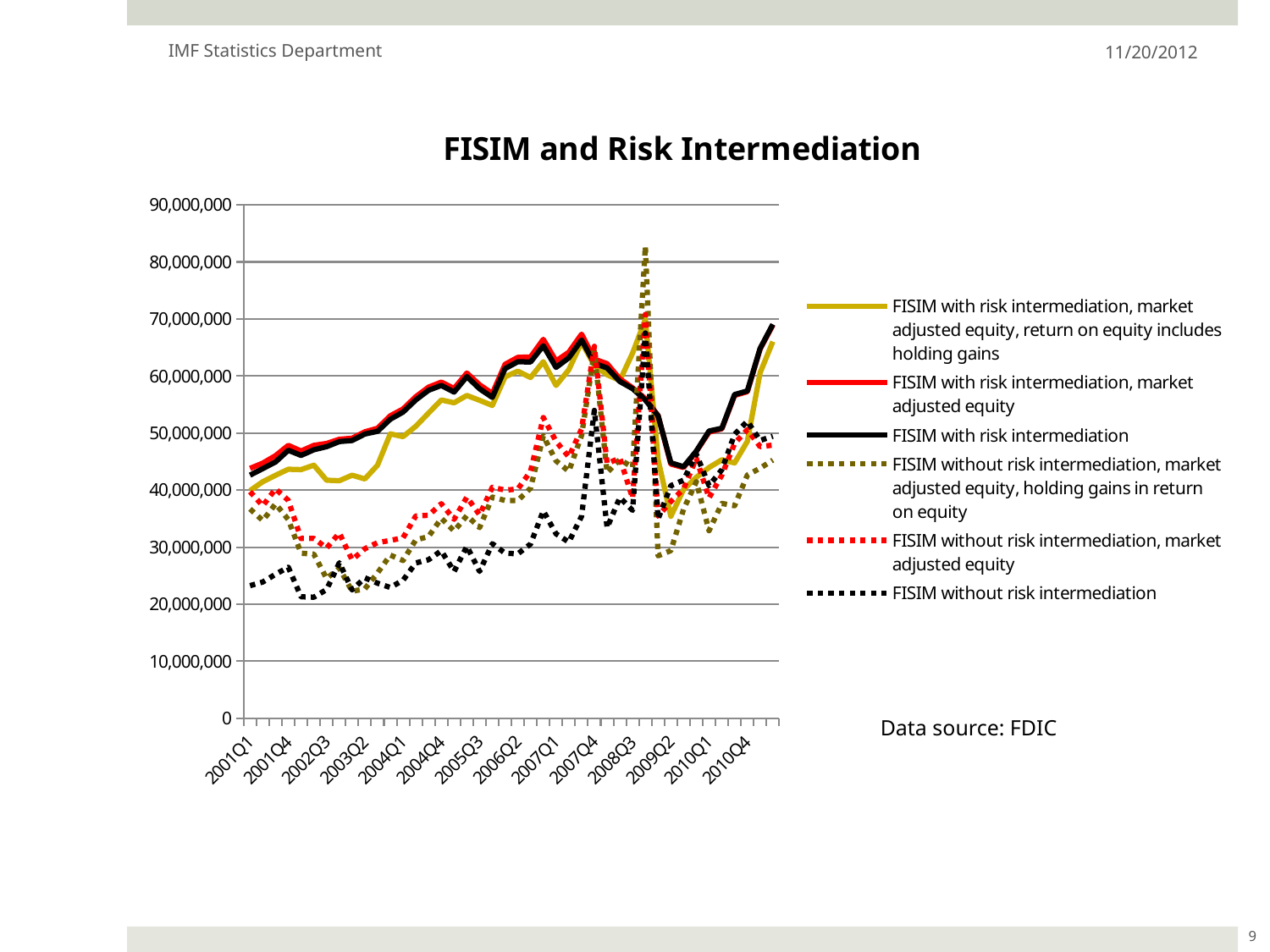
Is the value for FISIM with risk intermediation at 2010Q4 greater or less than 60,000,000? less At 2001Q1, which is larger: FISIM with risk intermediation or FISIM without risk intermediation? FISIM with risk intermediation Which series reaches the highest point on the chart? FISIM without risk intermediation, market adjusted equity, holding gains in return on equity How many series does the legend list? 6 Is the value for FISIM without risk intermediation at 2001Q1 greater or less than 30,000,000? less What data source is cited for the chart? FDIC Is the peak value of FISIM without risk intermediation, market adjusted equity, holding gains in return on equity (around 2008Q3) greater or less than 70,000,000? greater What is the title of the chart? FISIM and Risk Intermediation What type of chart is shown on the slide? Line chart How many quarter labels are shown on the x axis? 14 Does FISIM with risk intermediation generally rise or fall from 2001Q1 to 2007Q1? Rise